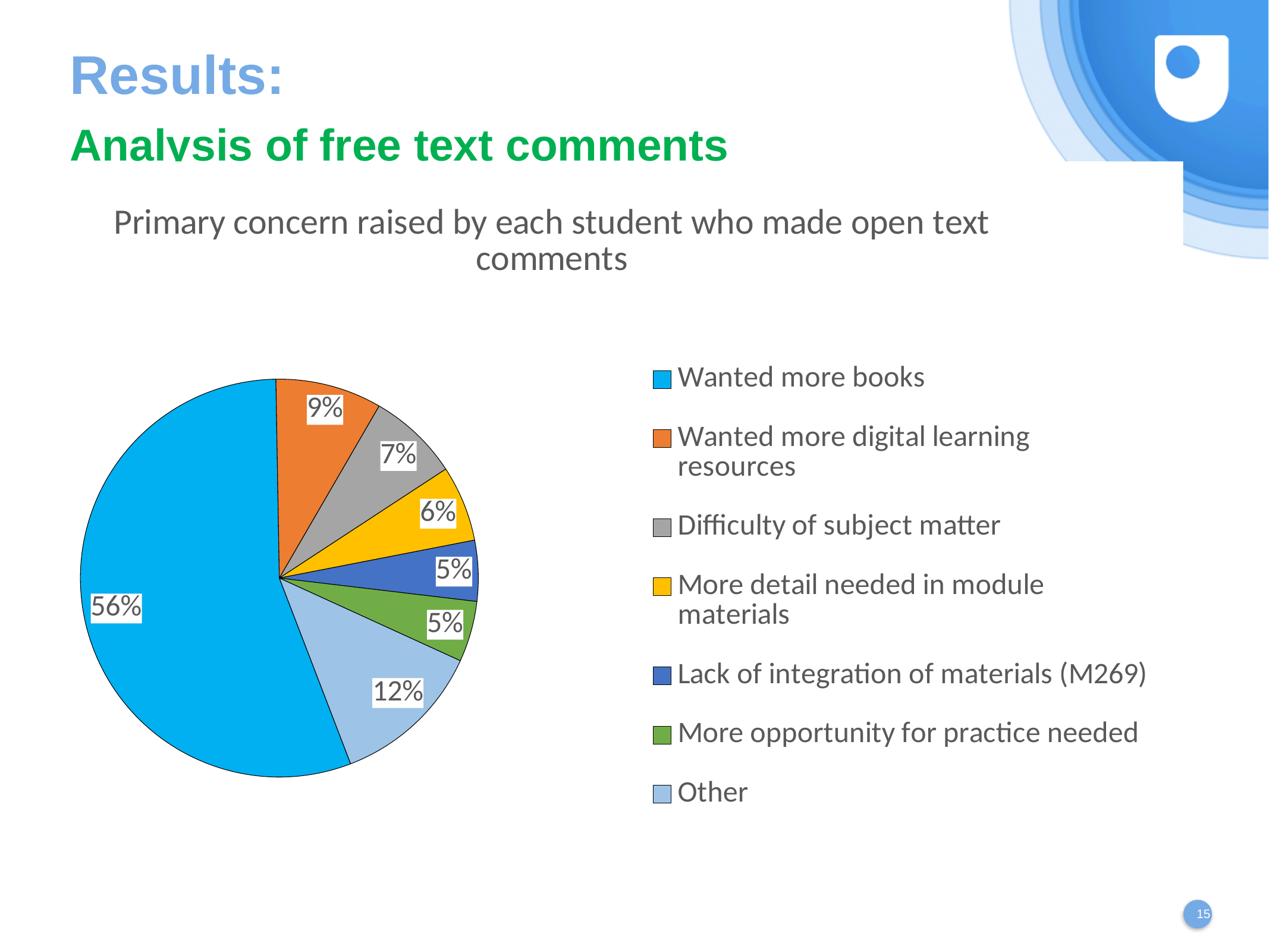
What share of the pie is 'Other'? 12% Which is larger: the share for 'Wanted more digital learning resources' or the share for 'Difficulty of subject matter'? Wanted more digital learning resources What share of the pie is 'More detail needed in module materials'? 6% What share of the pie is 'Difficulty of subject matter'? 7% What colour is the 'Other' slice in the pie chart? Light blue Which category has the largest slice of the pie? Wanted more books How many categories does the legend list? 7 What is the difference between the 'Wanted more books' share and the 'Other' share? 44% What kind of chart is shown on the slide? Pie chart What is the title of the pie chart? Primary concern raised by each student who made open text comments